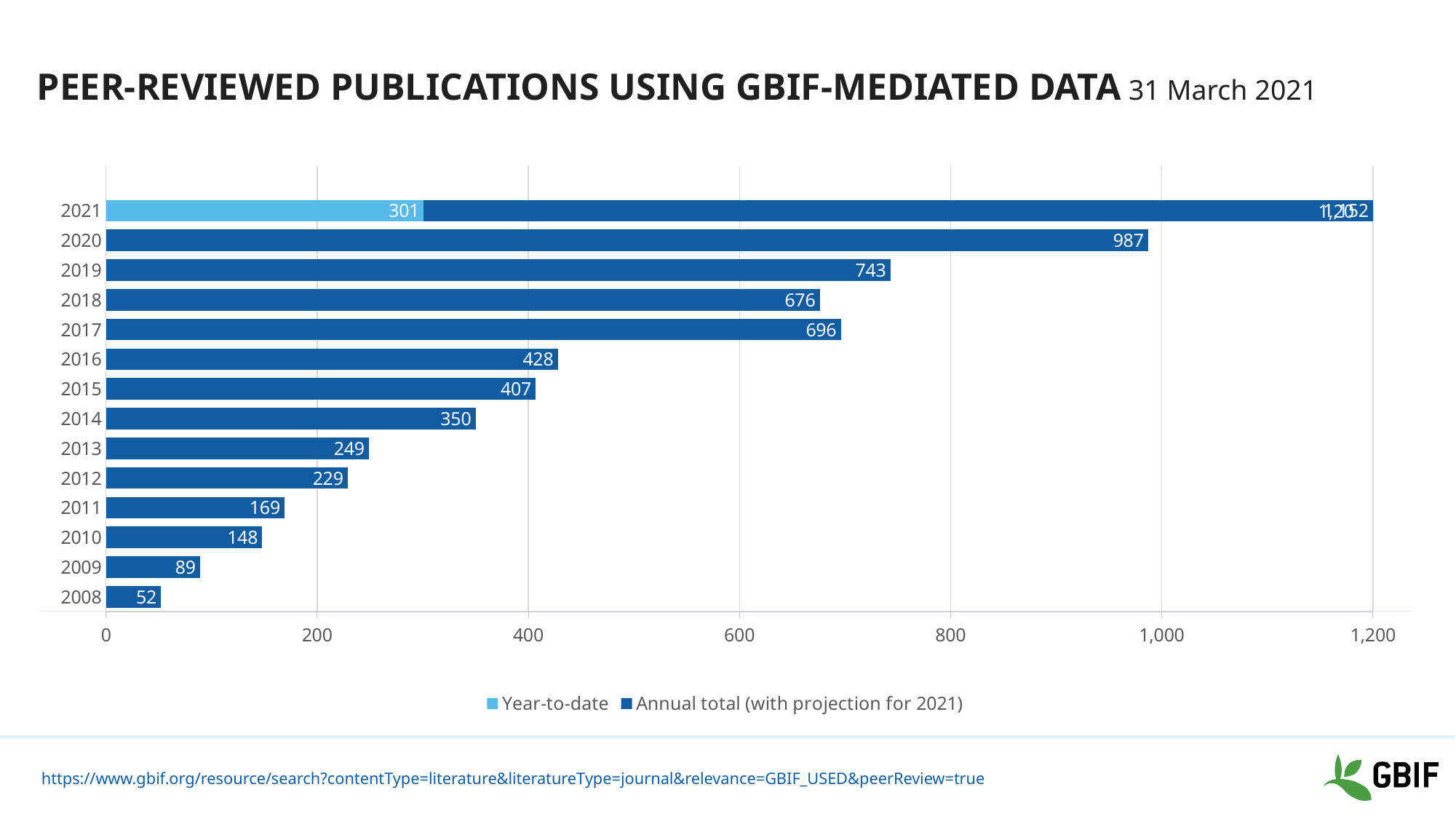
Which year has the lowest annual total? 2008 Do the annual totals generally rise or fall from 2008 to 2020? rise What is the annual total for 2008? 52 What is the annual total of peer-reviewed publications for 2020? 987 How many series does the legend list? 2 What kind of chart is shown on the slide? bar chart What is the date shown next to the chart title? 31 March 2021 Which is larger, the annual total for 2017 or for 2018? 2017 How many years are shown on the chart? 14 What is the difference between the annual totals for 2020 and 2019? 244 What is the year-to-date value for 2021? 301 Is the annual total for 2016 greater or less than 400? greater